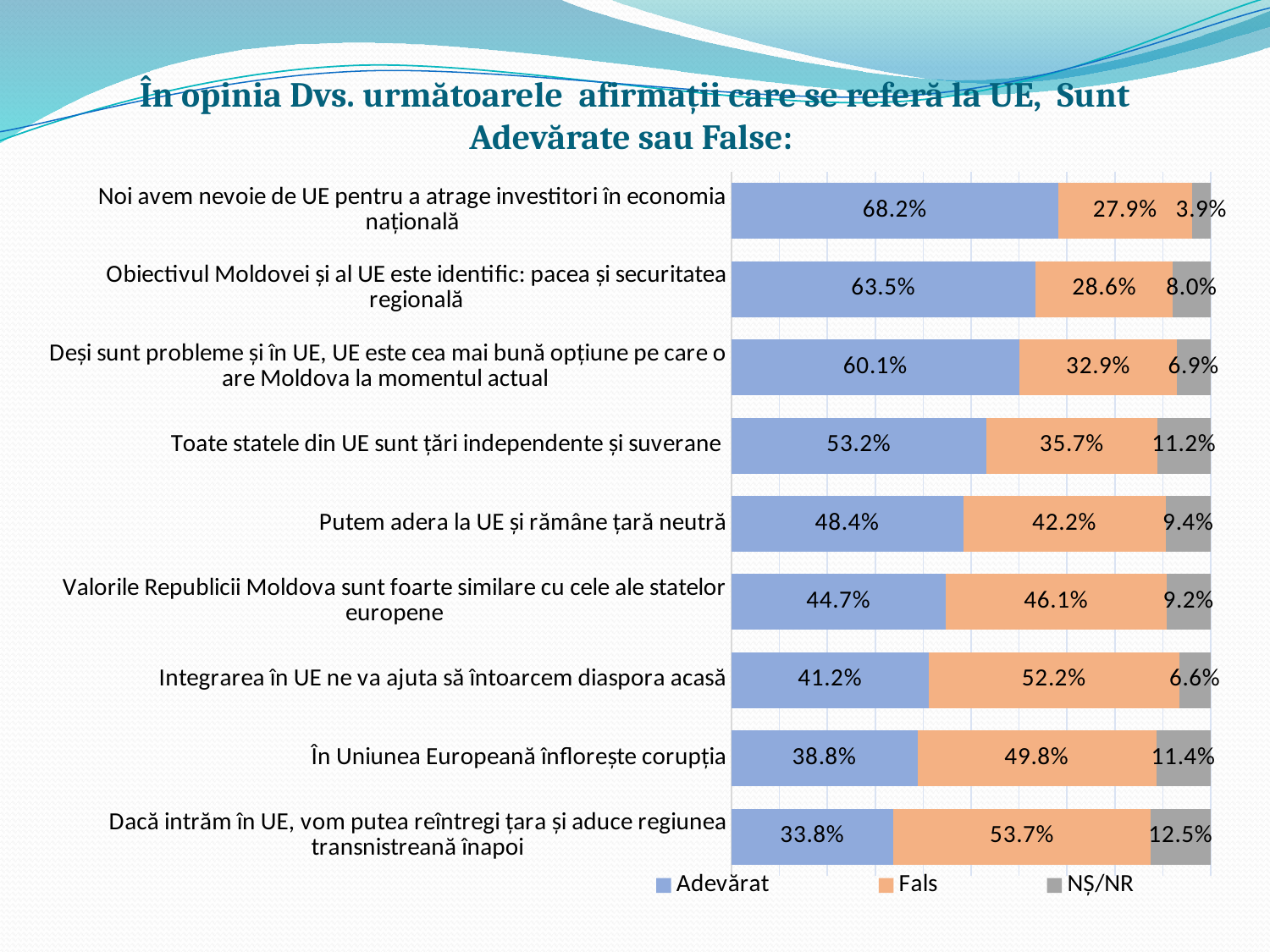
What is the total of the stacked bar for "Toate statele din UE sunt țări independente și suverane"? 100.1% What is the Fals value for "Integrarea în UE ne va ajuta să întoarcem diaspora acasă"? 52.2% Which statement has the lowest NȘ/NR value? Noi avem nevoie de UE pentru a atrage investitori în economia națională For "Putem adera la UE și rămâne țară neutră", which is larger: the Adevărat value or the Fals value? Adevărat How many statements (categories) are plotted in the chart? 9 What is the Adevărat value for "Noi avem nevoie de UE pentru a atrage investitori în economia națională"? 68.2% What is the NȘ/NR value for "Dacă intrăm în UE, vom putea reîntregi țara și aduce regiunea transnistreană înapoi"? 12.5% What kind of chart is shown on the slide? Stacked bar chart Which series is shown in orange in the chart? Fals Which statement has the highest Adevărat value? Noi avem nevoie de UE pentru a atrage investitori în economia națională What is the difference between the Fals value and the Adevărat value for "În Uniunea Europeană înflorește corupția"? 11.0% How many series does the legend list? 3